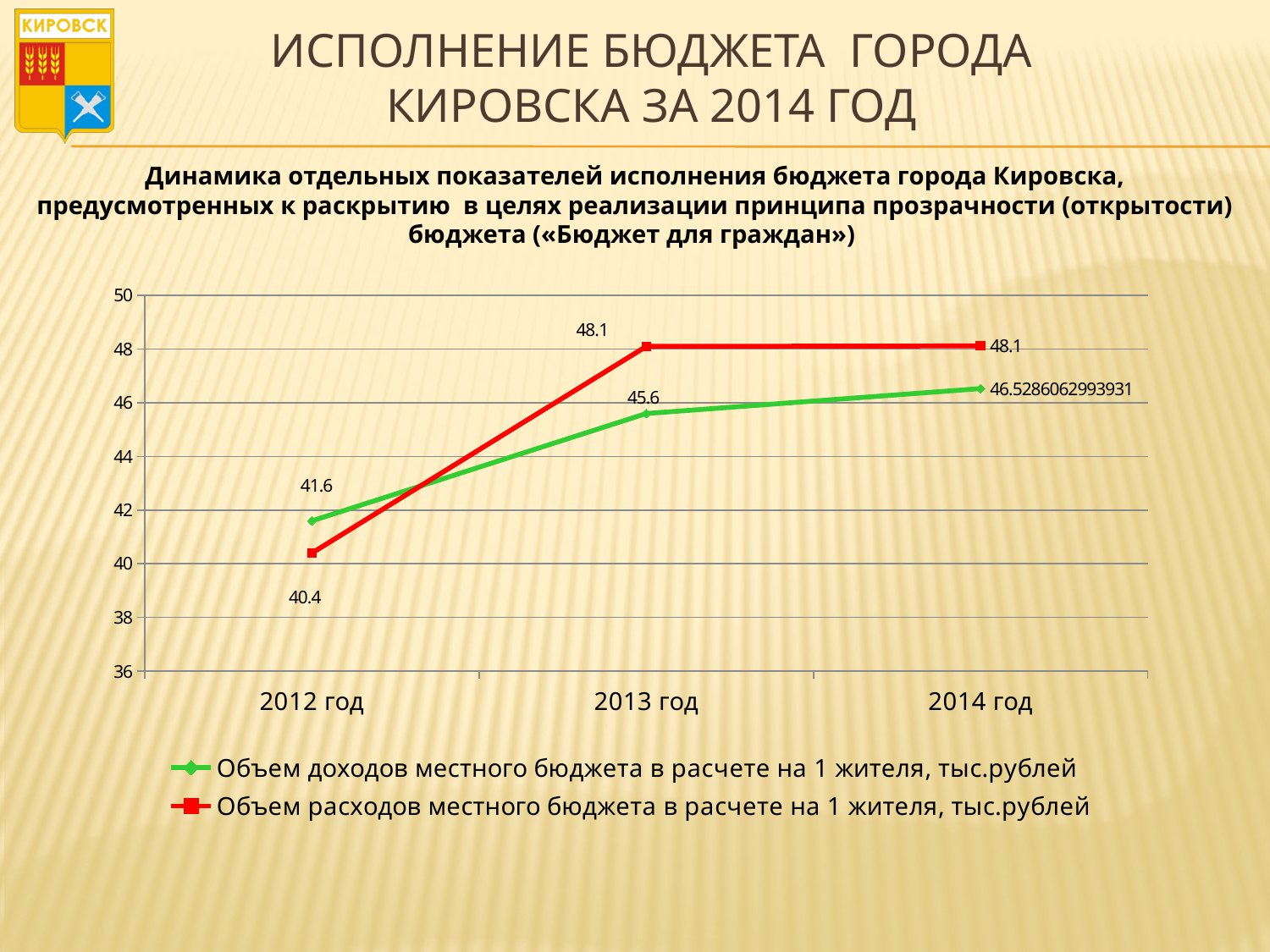
How many years are plotted on the x axis? 3 In which year is 'Объем доходов местного бюджета в расчете на 1 жителя, тыс.рублей' lowest? 2012 год What is the difference between 'Объем расходов' and 'Объем доходов' per resident in 2013 год? 2.5 In 2012 год, which is larger: 'Объем доходов' or 'Объем расходов' per resident? Объем доходов местного бюджета в расчете на 1 жителя, тыс.рублей What type of chart is shown on the slide? line chart What is the value of 'Объем доходов местного бюджета в расчете на 1 жителя, тыс.рублей' for 2014 год? 46.5286062993931 What is the value of 'Объем расходов местного бюджета в расчете на 1 жителя, тыс.рублей' for 2014 год? 48.1 What is the value of 'Объем доходов местного бюджета в расчете на 1 жителя, тыс.рублей' for 2012 год? 41.6 Does 'Объем доходов местного бюджета в расчете на 1 жителя, тыс.рублей' rise or fall from 2012 год to 2014 год? rise What is the value of 'Объем доходов местного бюджета в расчете на 1 жителя, тыс.рублей' for 2013 год? 45.6 How many series does the legend list? 2 What is the value of 'Объем расходов местного бюджета в расчете на 1 жителя, тыс.рублей' for 2012 год? 40.4